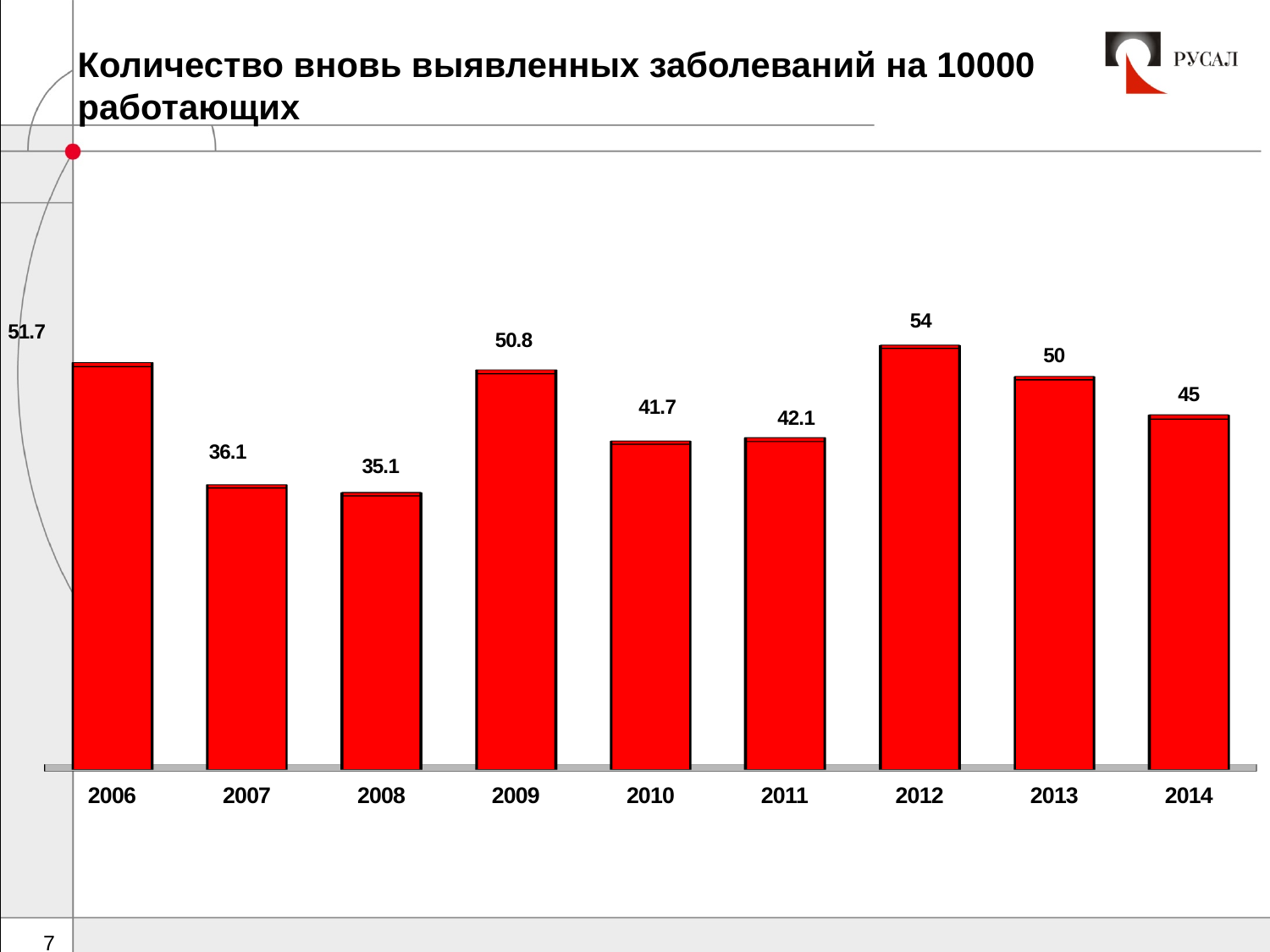
What colour are the bars in the chart? red Which is larger, the value for 2010 or the value for 2011? 2011 Which year has the highest value? 2012 How many years are shown on the x axis? 9 Which year has the lowest value? 2008 What is the difference between the values for 2012 and 2013? 4 What is the value for 2014? 45 What kind of chart is shown on the slide? bar chart What is the value for 2006? 51.7 What is the difference between the values for 2007 and 2008? 1 What is the value for 2009? 50.8 Do the values rise or fall from 2012 to 2014? fall